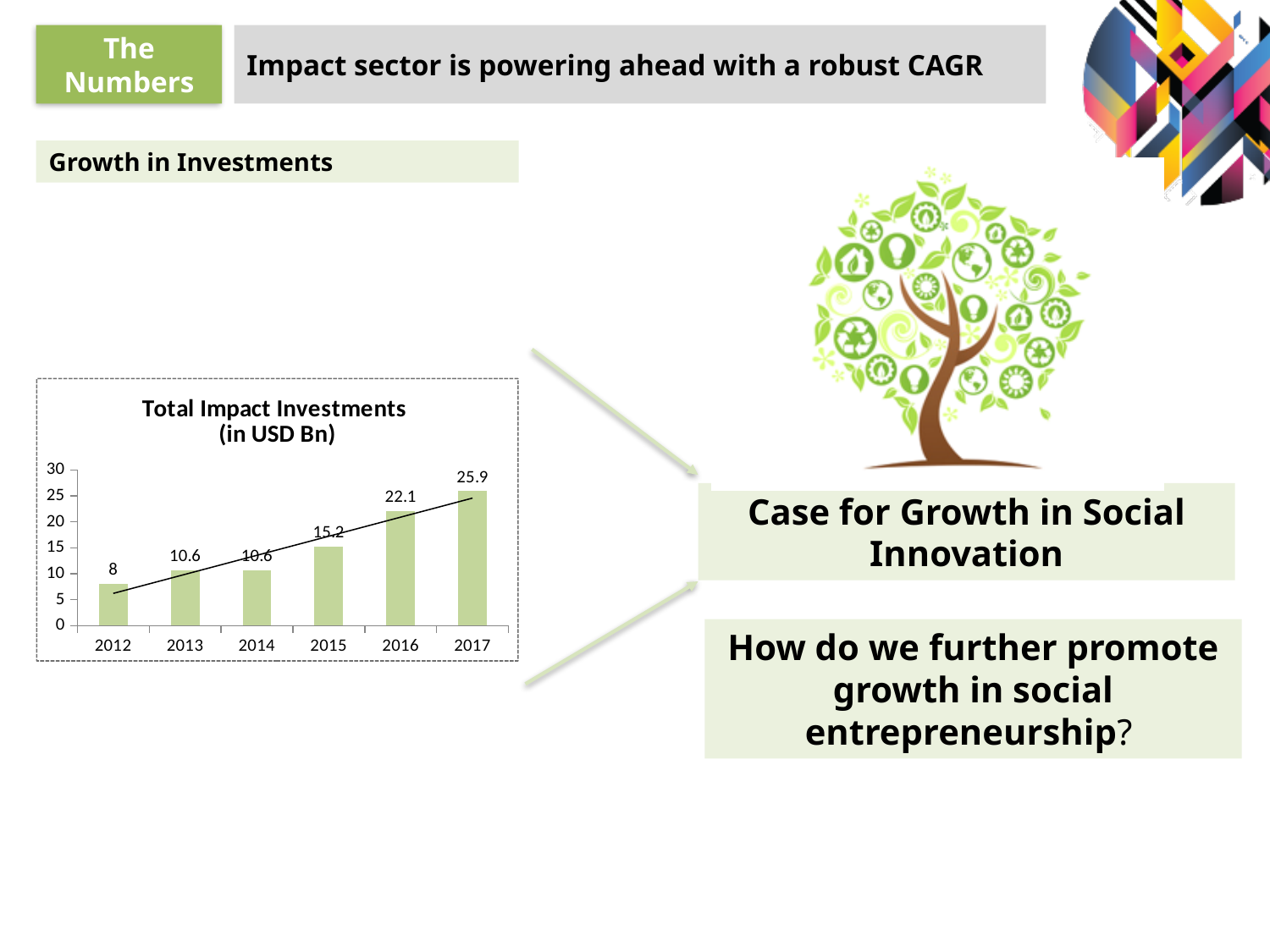
What is the value for 2012 in the Total Impact Investments chart? 8 What is the value for 2015 in the Total Impact Investments chart? 15.2 What kind of chart is the Total Impact Investments chart? Bar chart What is the difference between the 2016 and 2012 values in the Total Impact Investments chart? 14.1 How many years are shown on the x axis of the Total Impact Investments chart? 6 What is the value for 2016 in the Total Impact Investments chart? 22.1 What is the difference between the 2017 and 2016 values in the Total Impact Investments chart? 3.8 What is the value for 2017 in the Total Impact Investments chart? 25.9 Which year has the highest total impact investments? 2017 Do the values in the Total Impact Investments chart generally rise or fall from 2012 to 2017? Rise Which is larger in the Total Impact Investments chart, the value for 2015 or the value for 2013? 2015 Which year has the lowest total impact investments? 2012